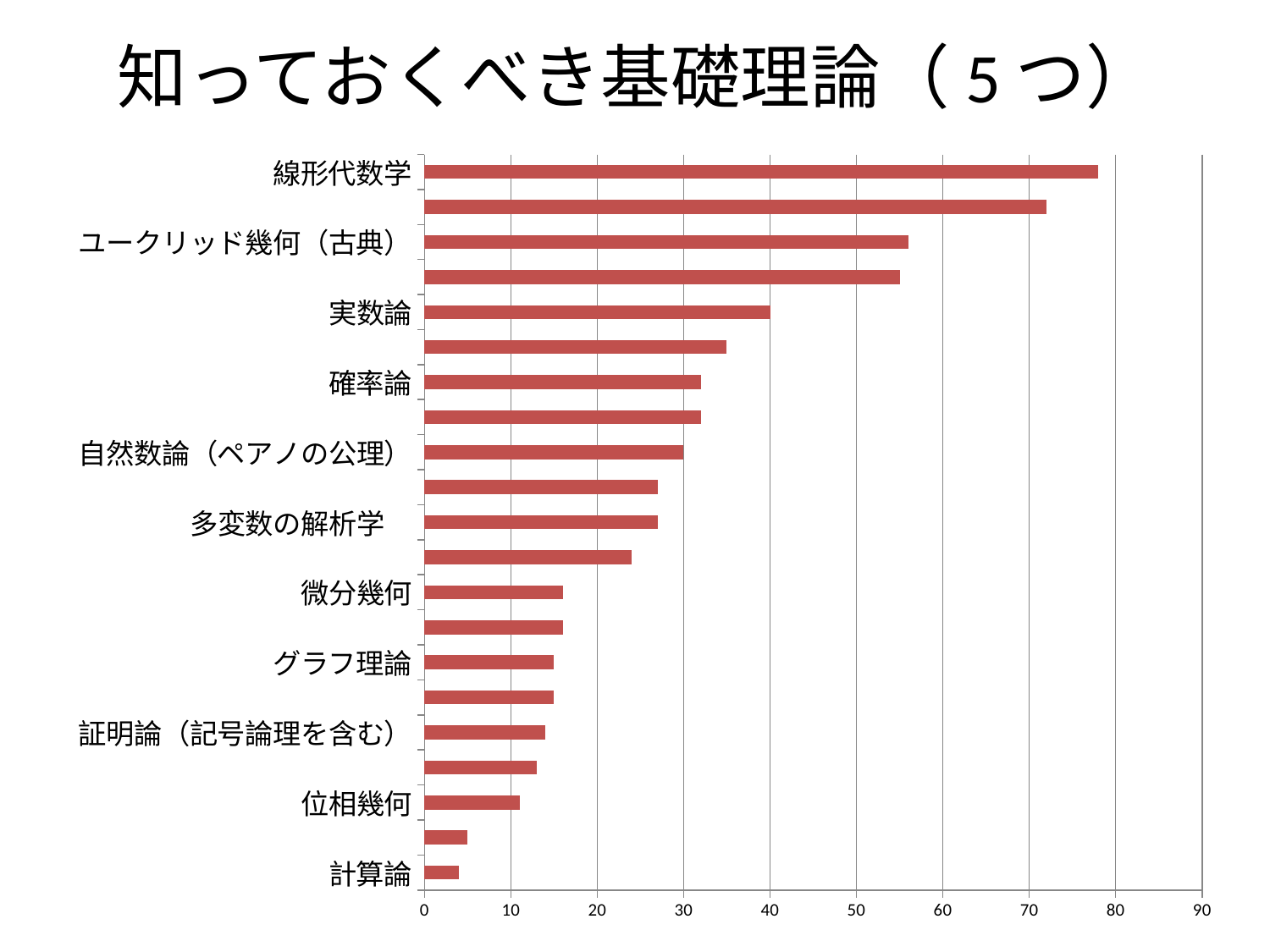
Which labeled category has the lowest value? 計算論 What is the title of the slide? 知っておくべき基礎理論（５つ） Which category has the highest value? 線形代数学 Is the value for 微分幾何 greater or less than 20? less Which is larger, the value for 線形代数学 or the value for ユークリッド幾何（古典）? 線形代数学 Is the value for 計算論 greater or less than 10? less Is the value for 多変数の解析学 greater or less than 30? less What kind of chart is shown on the slide? bar chart Which is larger, the value for 実数論 or the value for 確率論? 実数論